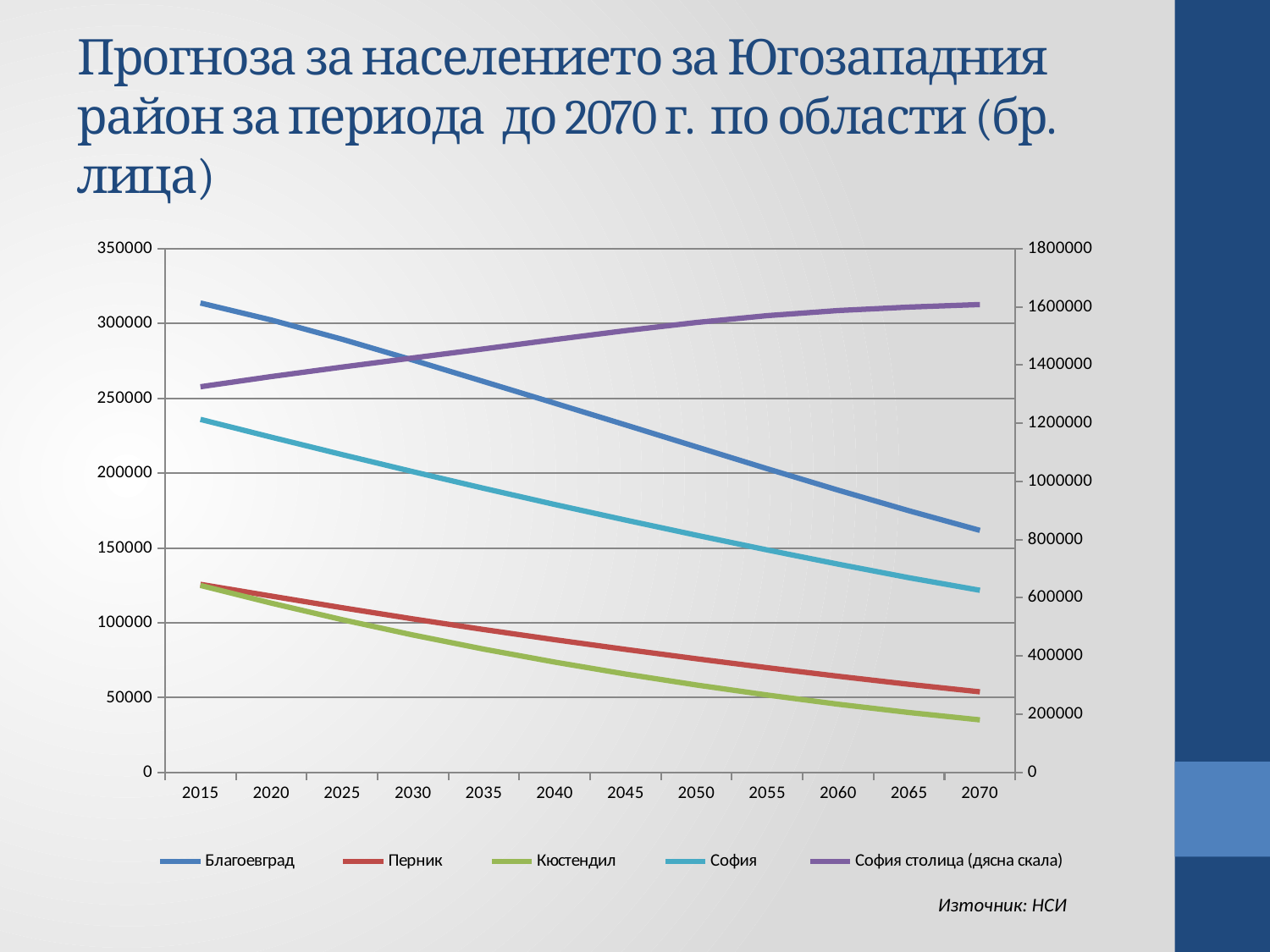
Does the line for София столица (дясна скала) rise or fall from 2015 to 2070? rise Is the value for София столица (дясна скала) in 2015 greater or less than 1200000 on the right axis? greater Is the value for София in 2015 greater or less than 250000? less In 2070, which is larger, the value for Перник or the value for Кюстендил? Перник Is the value for Благоевград in 2015 greater or less than 300000? greater Does the line for Благоевград rise or fall from 2015 to 2070? fall How many years are marked along the x axis? 12 Among the series plotted on the left axis, which has the lowest value in 2070? Кюстендил How many series does the legend list? 5 Which series is plotted on the right-hand scale according to the legend? София столица (дясна скала) What kind of chart is shown on the slide? line chart